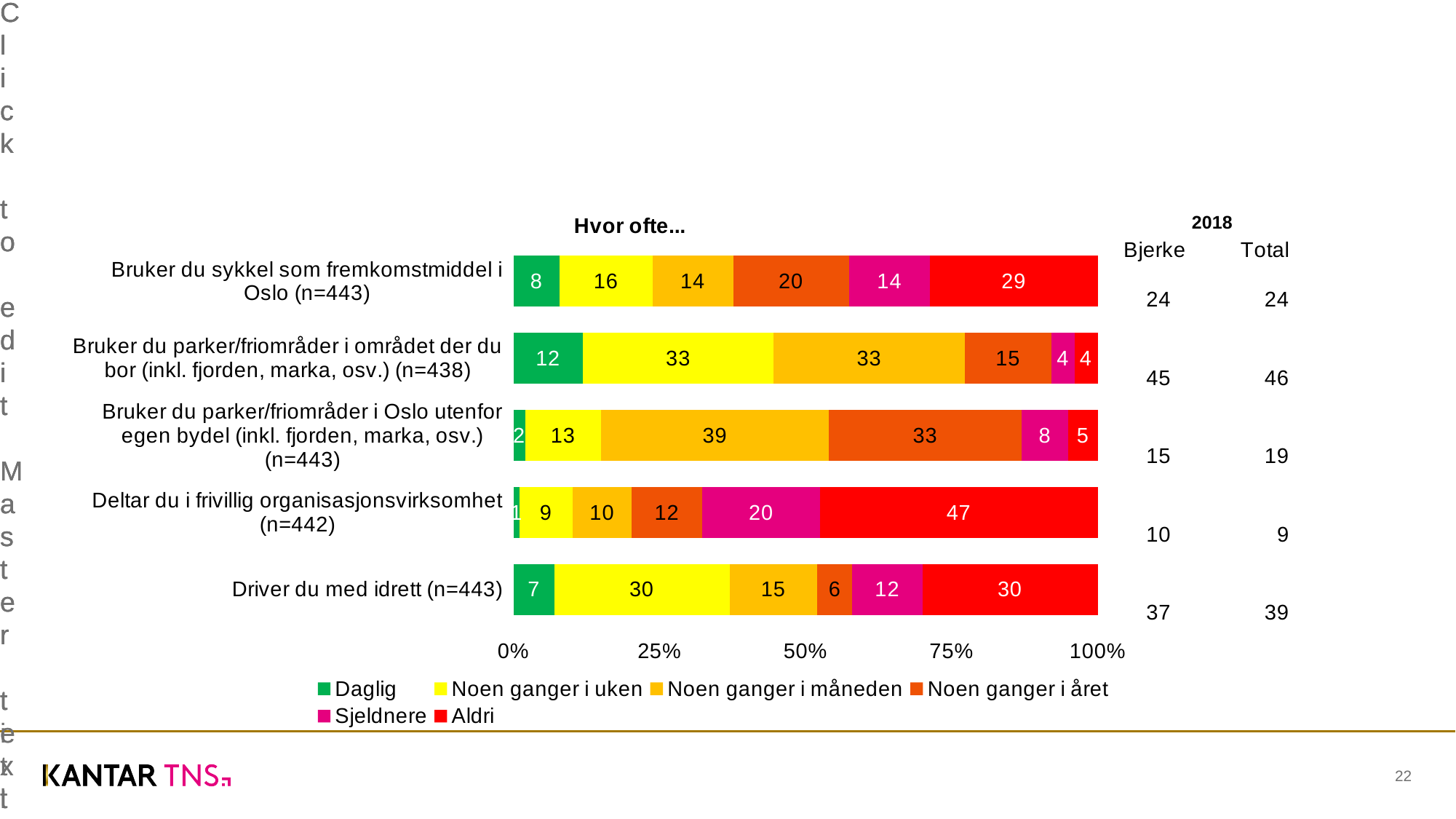
What kind of chart is shown on the slide? Stacked bar chart Which category has the highest value for "Aldri"? Deltar du i frivillig organisasjonsvirksomhet (n=442) What is the value for "Aldri" for "Deltar du i frivillig organisasjonsvirksomhet (n=442)"? 47 What is the total of the stacked bar for "Driver du med idrett (n=443)"? 100 How many series does the legend list? 6 Which category has the lowest value for "Daglig"? Deltar du i frivillig organisasjonsvirksomhet (n=442) Which is larger: the "Noen ganger i uken" value for "Driver du med idrett (n=443)" or for "Bruker du sykkel som fremkomstmiddel i Oslo (n=443)"? Driver du med idrett (n=443) How many categories (questions) are shown in the chart? 5 What is the value for "Daglig" for "Bruker du parker/friområder i området der du bor (inkl. fjorden, marka, osv.) (n=438)"? 12 What is the value for "Sjeldnere" for "Bruker du sykkel som fremkomstmiddel i Oslo (n=443)"? 14 What is the value for "Noen ganger i måneden" for "Bruker du parker/friområder i Oslo utenfor egen bydel (inkl. fjorden, marka, osv.) (n=443)"? 39 What is the difference between the "Aldri" value for "Driver du med idrett (n=443)" and the "Aldri" value for "Bruker du parker/friområder i området der du bor (inkl. fjorden, marka, osv.) (n=438)"? 26